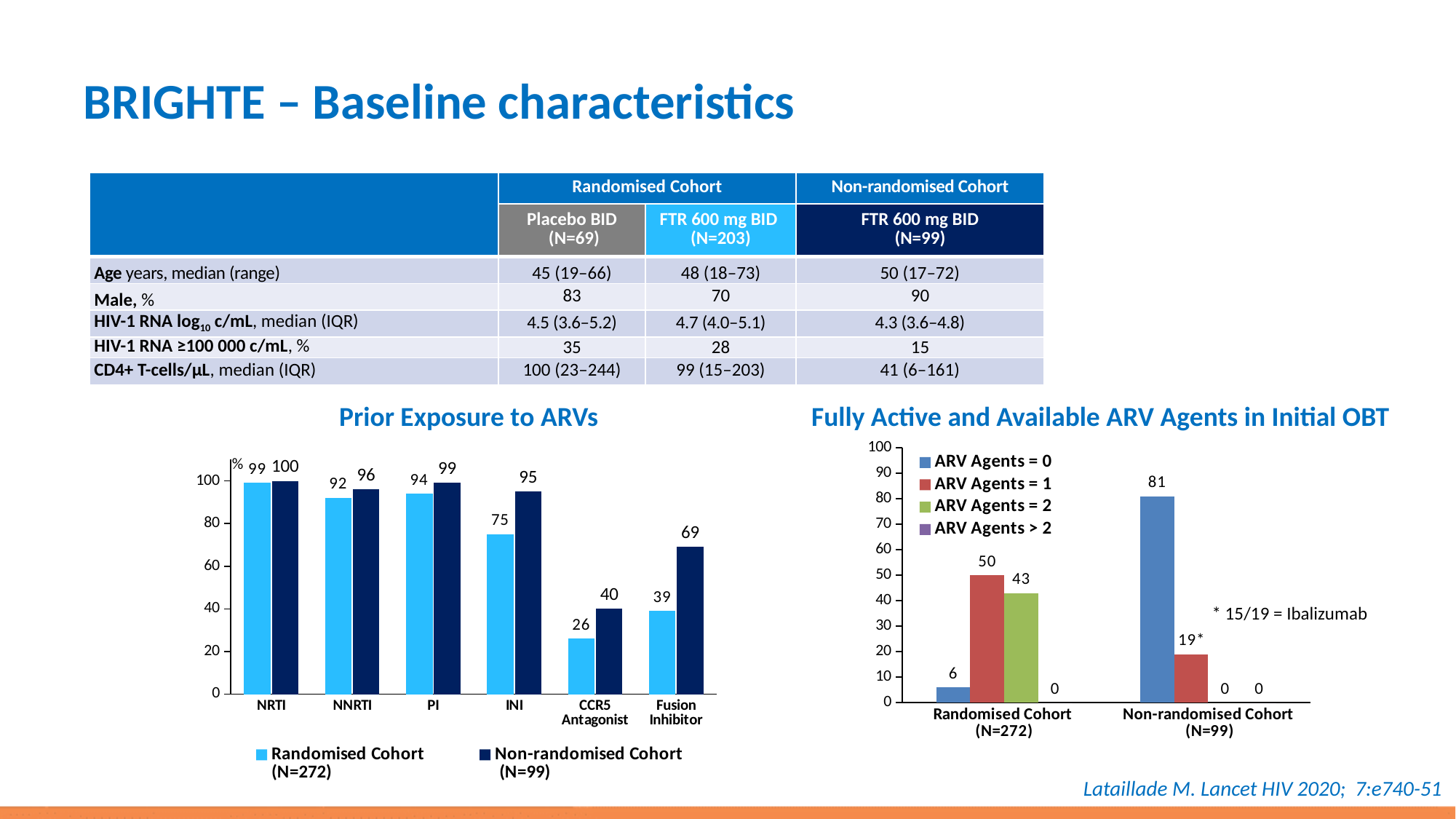
In the 'Prior Exposure to ARVs' chart, how many ARV categories are shown on the x axis? 6 In the 'Prior Exposure to ARVs' chart, which category has the lowest value for the Randomised Cohort? CCR5 Antagonist In the 'Prior Exposure to ARVs' chart, what is the difference between the Non-randomised Cohort and Randomised Cohort values for Fusion Inhibitor? 30 In the 'Prior Exposure to ARVs' chart, which cohort has the higher value for CCR5 Antagonist? Non-randomised Cohort In the 'Fully Active and Available ARV Agents in Initial OBT' chart, which series is shown in red? ARV Agents = 1 In the 'Fully Active and Available ARV Agents in Initial OBT' chart, how many series does the legend list? 4 In the 'Prior Exposure to ARVs' chart, what is the value for the Randomised Cohort for INI? 75 In the 'Fully Active and Available ARV Agents in Initial OBT' chart, what is the value for ARV Agents = 2 in the Randomised Cohort? 43 In the 'Fully Active and Available ARV Agents in Initial OBT' chart, what is the difference between ARV Agents = 1 and ARV Agents = 0 in the Randomised Cohort? 44 What kind of chart is the 'Fully Active and Available ARV Agents in Initial OBT' chart? Bar chart In the 'Fully Active and Available ARV Agents in Initial OBT' chart, what is the value for ARV Agents = 0 in the Non-randomised Cohort? 81 In the 'Prior Exposure to ARVs' chart, what is the value for the Non-randomised Cohort for Fusion Inhibitor? 69